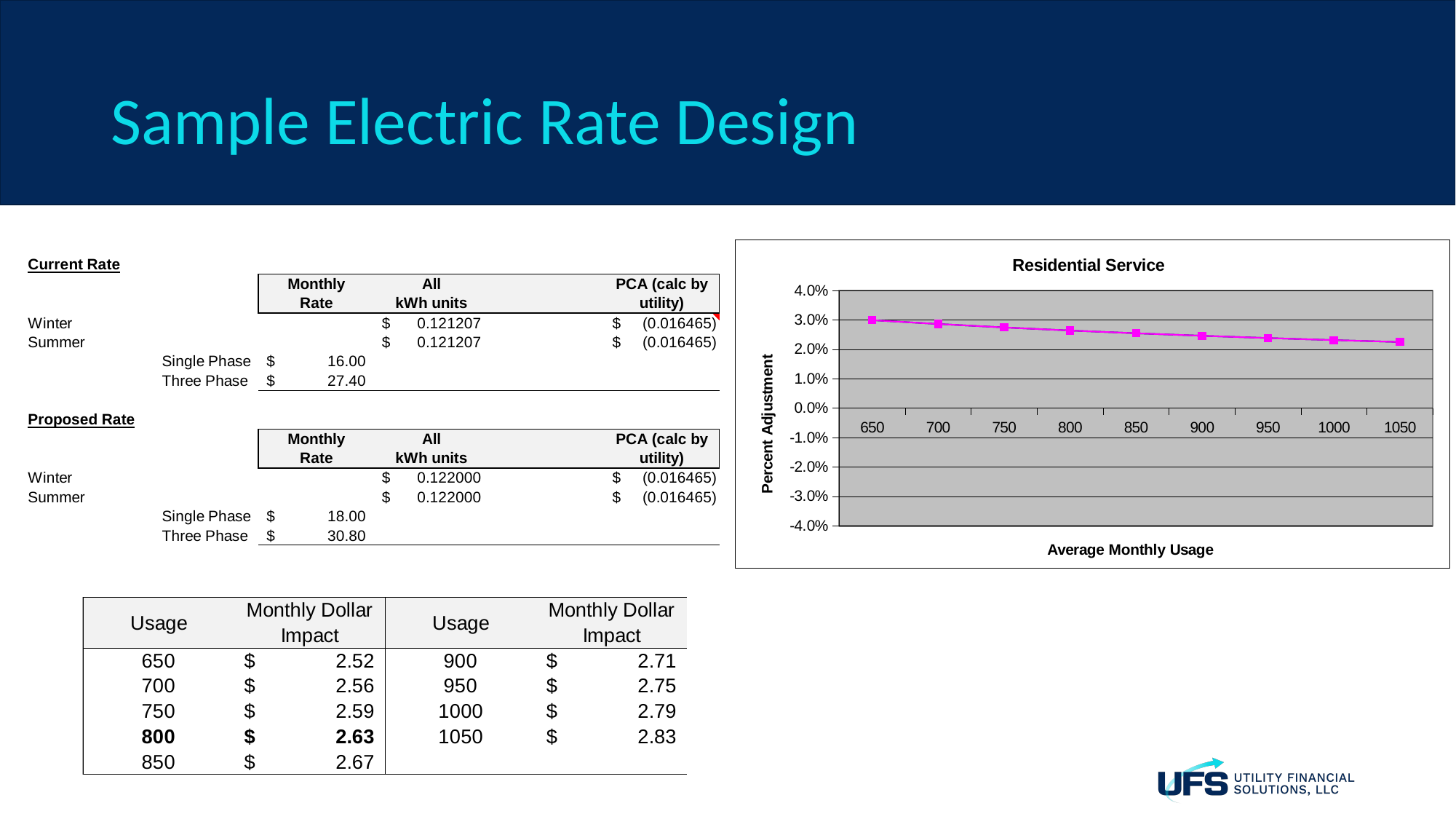
Which average monthly usage has the lowest percent adjustment on the Residential Service chart? 1050 What is the title of the chart on the slide? Residential Service What kind of chart is the Residential Service chart? line chart What is the label of the x axis of the Residential Service chart? Average Monthly Usage On the Residential Service chart, is the percent adjustment at 750 greater or less than 2.0%? greater Which average monthly usage has the highest percent adjustment on the Residential Service chart? 650 On the Residential Service chart, is the percent adjustment at 650 greater or less than 4.0%? less Do the values on the Residential Service chart rise or fall as average monthly usage increases? fall On the Residential Service chart, which has the larger percent adjustment, 700 or 1000? 700 On the Residential Service chart, is the percent adjustment at 900 greater or less than 0.0%? greater How many data points are plotted on the Residential Service chart? 9